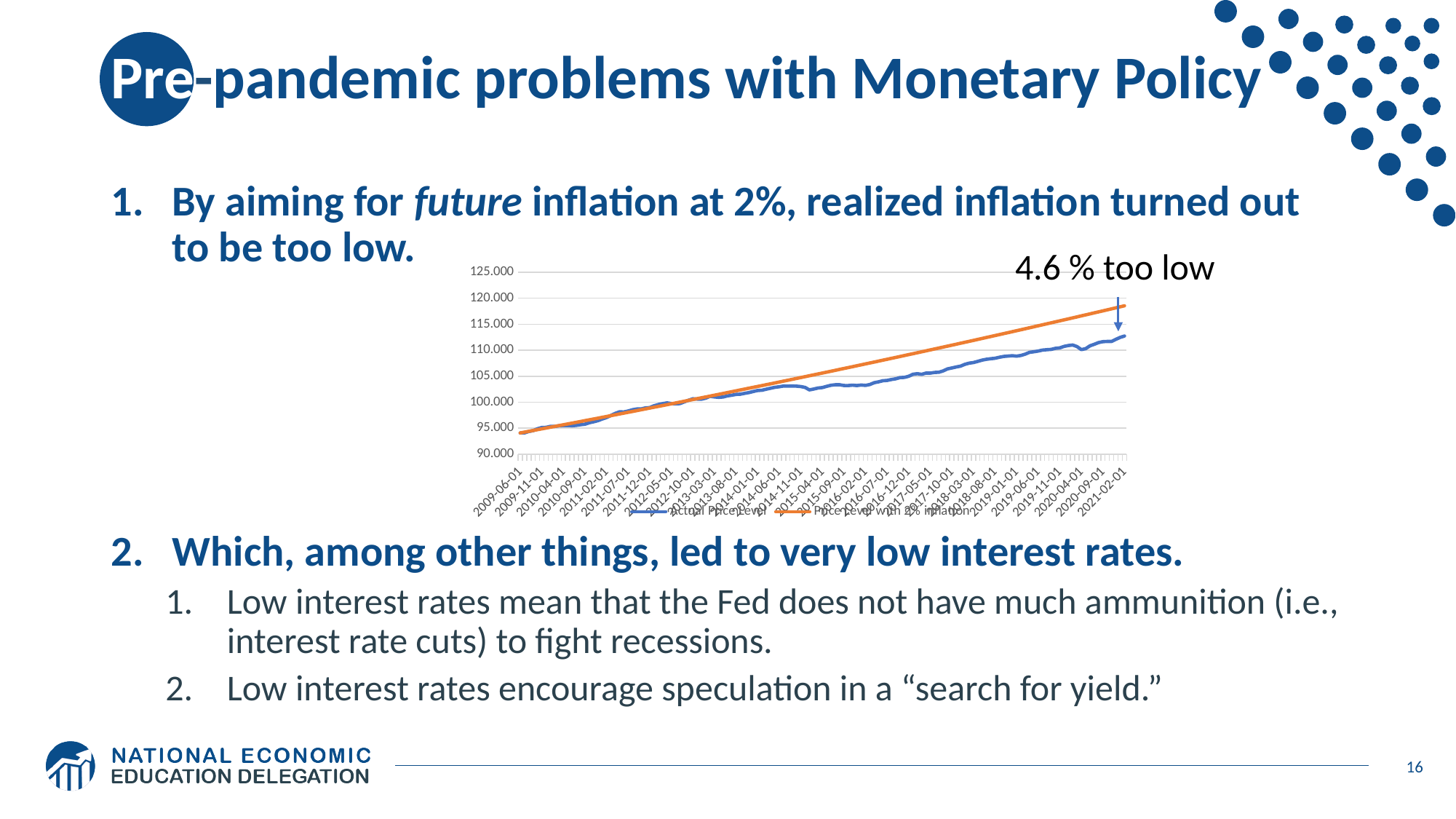
What does the annotation next to the end of the chart say? 4.6 % too low What kind of chart is shown on the slide? line chart Is the Actual Price Level at 2015-04-01 greater or less than 100.000? greater What is the highest tick value shown on the chart's y axis? 125.000 How many series does the chart's legend list? 2 What are the two series named in the chart's legend? Actual Price Level; Price Level with 2% inflation What is the first date label on the chart's x axis? 2009-06-01 At 2021-02-01, which series is higher: Actual Price Level or Price Level with 2% inflation? Price Level with 2% inflation Is the Actual Price Level at 2021-02-01 greater or less than 110.000? greater Is the Actual Price Level at 2009-06-01 greater or less than 95.000? less Does the Actual Price Level series generally rise or fall from 2009-06-01 to 2021-02-01? rise